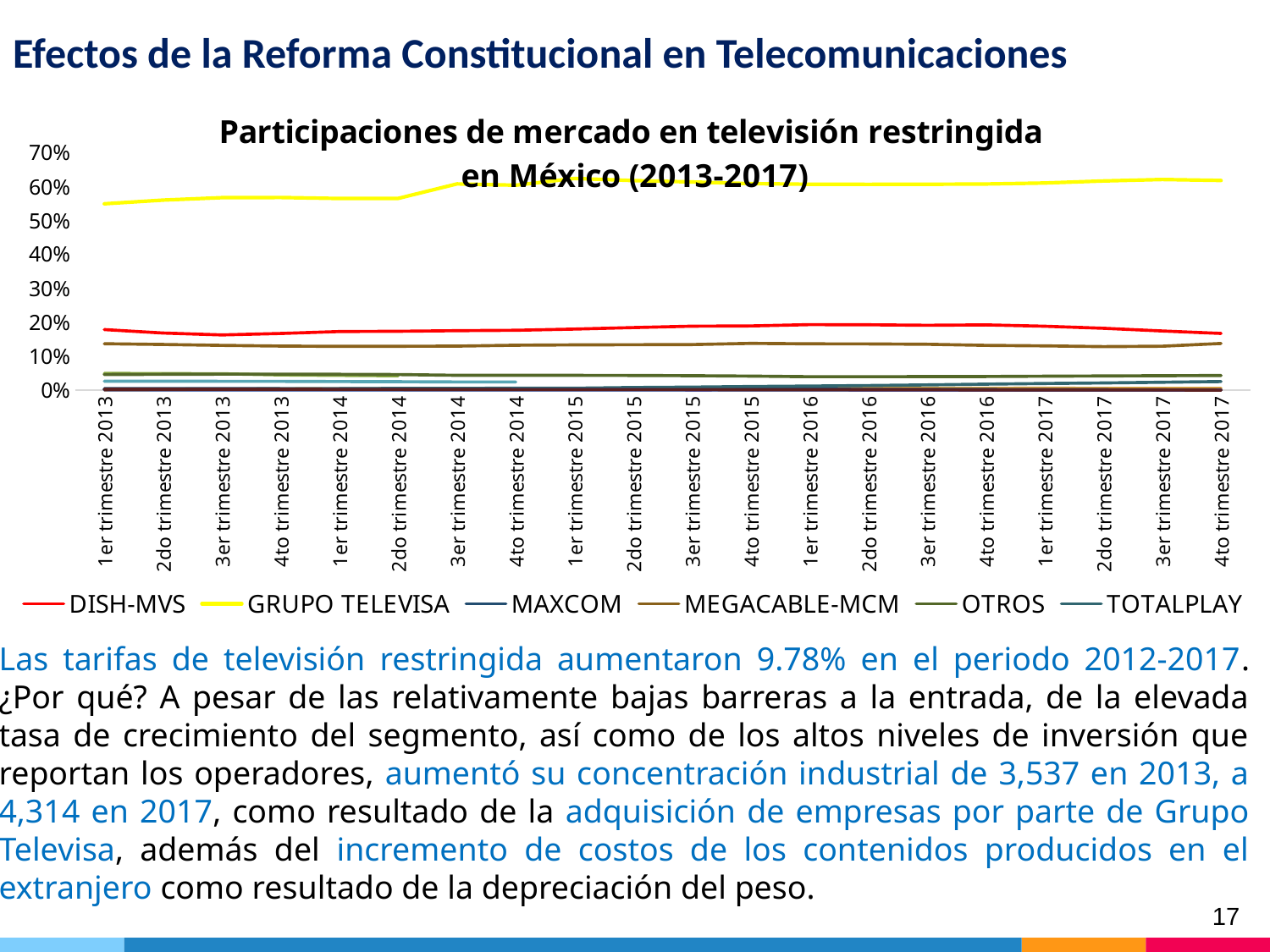
Does the GRUPO TELEVISA line rise or fall from 1er trimestre 2013 to 4to trimestre 2017? rise Is the value for GRUPO TELEVISA in 1er trimestre 2013 greater or less than 60%? less Is the value for DISH-MVS in 1er trimestre 2013 greater or less than 10%? greater Is the value for GRUPO TELEVISA in 4to trimestre 2017 greater or less than 60%? greater How many series does the legend list? 6 How many quarters are plotted along the x axis? 20 Which series has the highest market share throughout the period? GRUPO TELEVISA What kind of chart is shown on the slide? line chart What colour is the GRUPO TELEVISA line? yellow In 1er trimestre 2013, which is larger: DISH-MVS or MEGACABLE-MCM? DISH-MVS